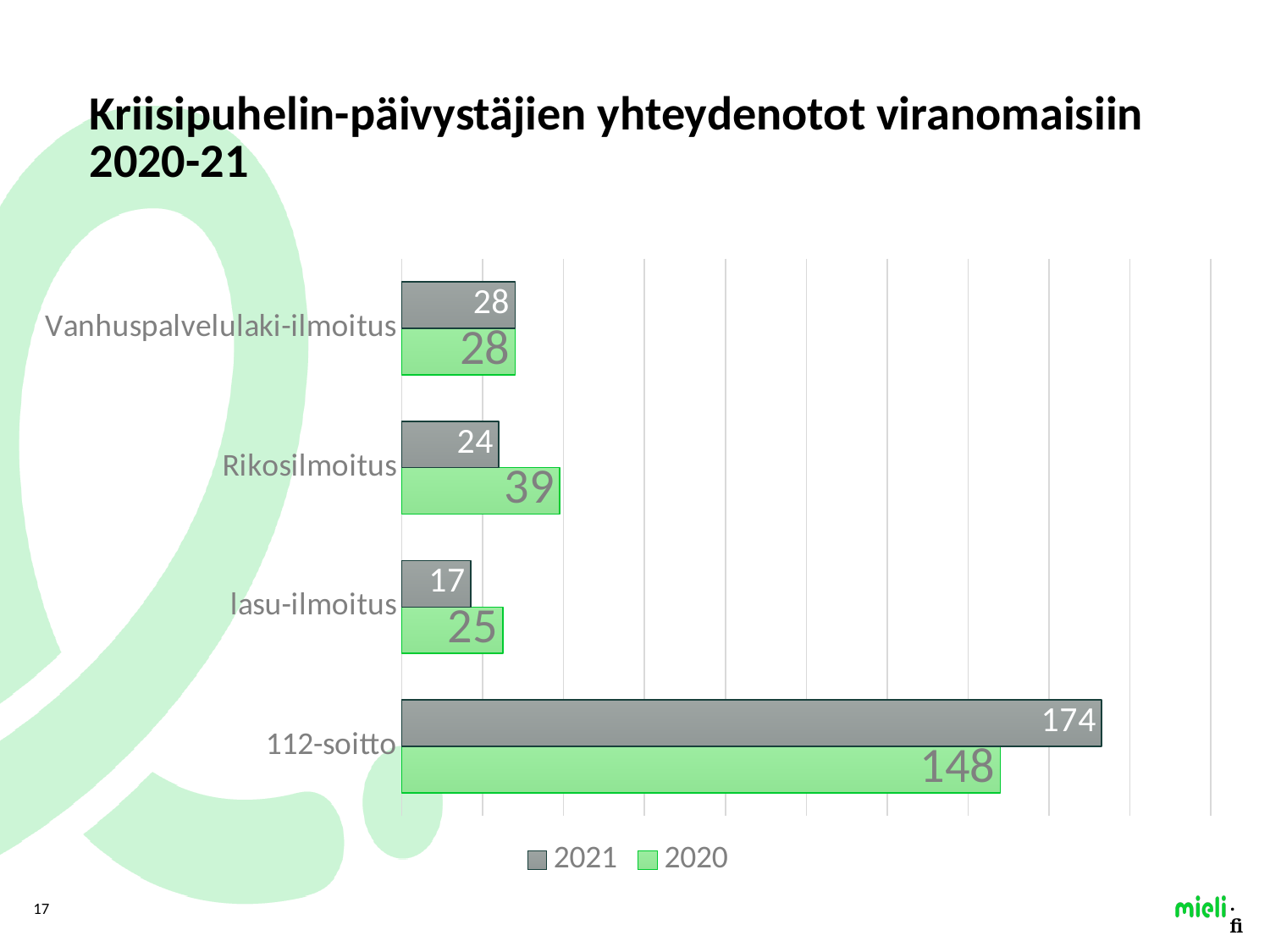
What is the value for lasu-ilmoitus in 2021? 17 What is the value for Rikosilmoitus in 2020? 39 Which category has the highest value in 2021? 112-soitto Which category has the lowest value in 2020? lasu-ilmoitus How many categories are shown on the chart? 4 What is the value for Vanhuspalvelulaki-ilmoitus in 2020? 28 What is the value for 112-soitto in 2021? 174 Which is larger for Rikosilmoitus, the 2021 value or the 2020 value? 2020 What kind of chart is shown on the slide? Bar chart What is the difference between the 2021 and 2020 values for 112-soitto? 26 How many series does the legend list? 2 Which colour represents the 2020 series? Green